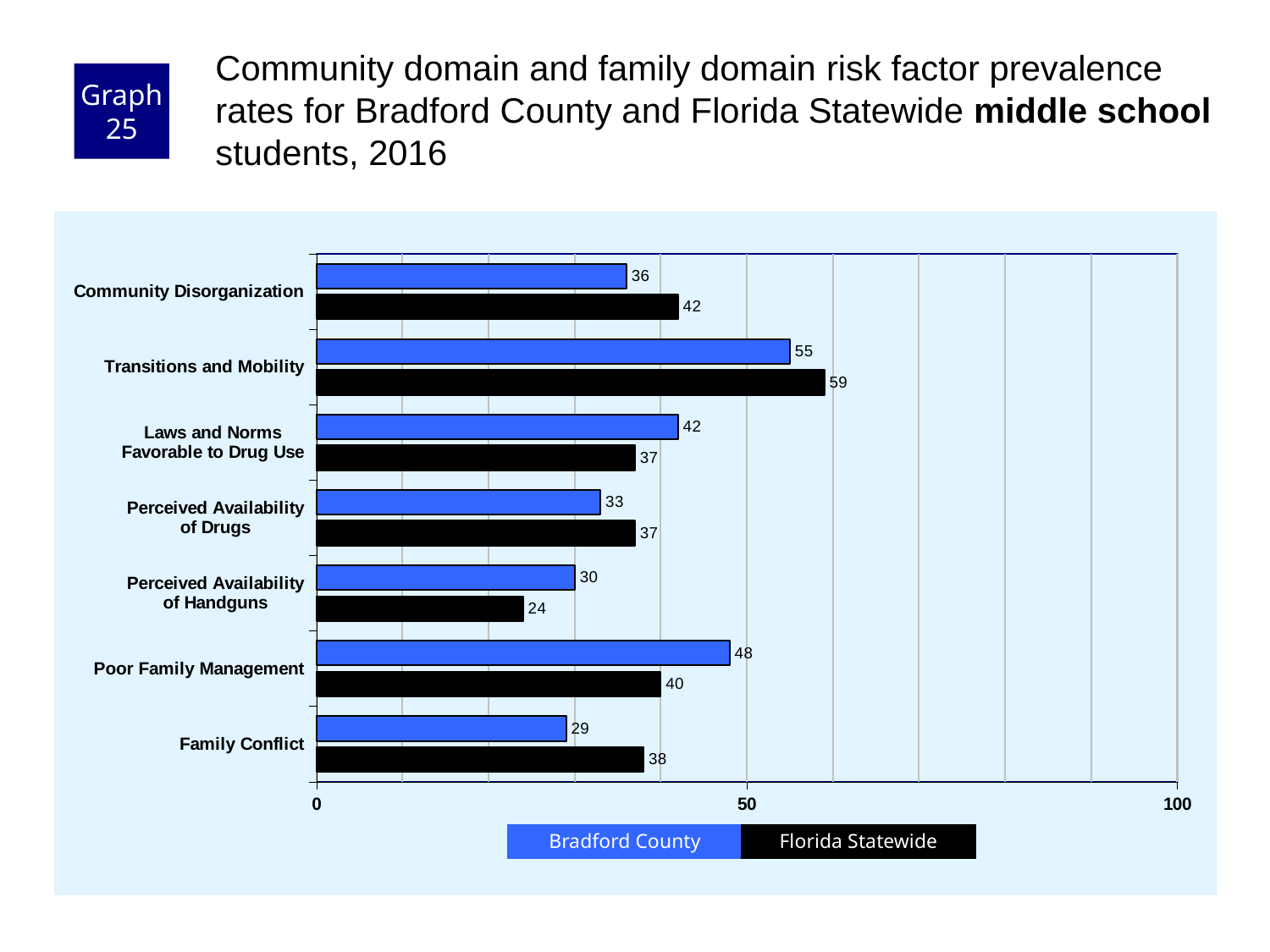
What is the Bradford County value for Transitions and Mobility? 55 Which risk factor has the highest Florida Statewide value? Transitions and Mobility Which series is shown in black? Florida Statewide Is the Florida Statewide value for Transitions and Mobility greater or less than 50? greater Which risk factor has the lowest Bradford County value? Family Conflict How many risk factor categories are shown on the chart? 7 What is the difference between the Florida Statewide and Bradford County values for Community Disorganization? 6 For Poor Family Management, which is larger: the Bradford County value or the Florida Statewide value? Bradford County What is the Bradford County value for Perceived Availability of Handguns? 30 What kind of chart is shown on the slide? bar chart How many series does the legend list? 2 What is the Florida Statewide value for Family Conflict? 38